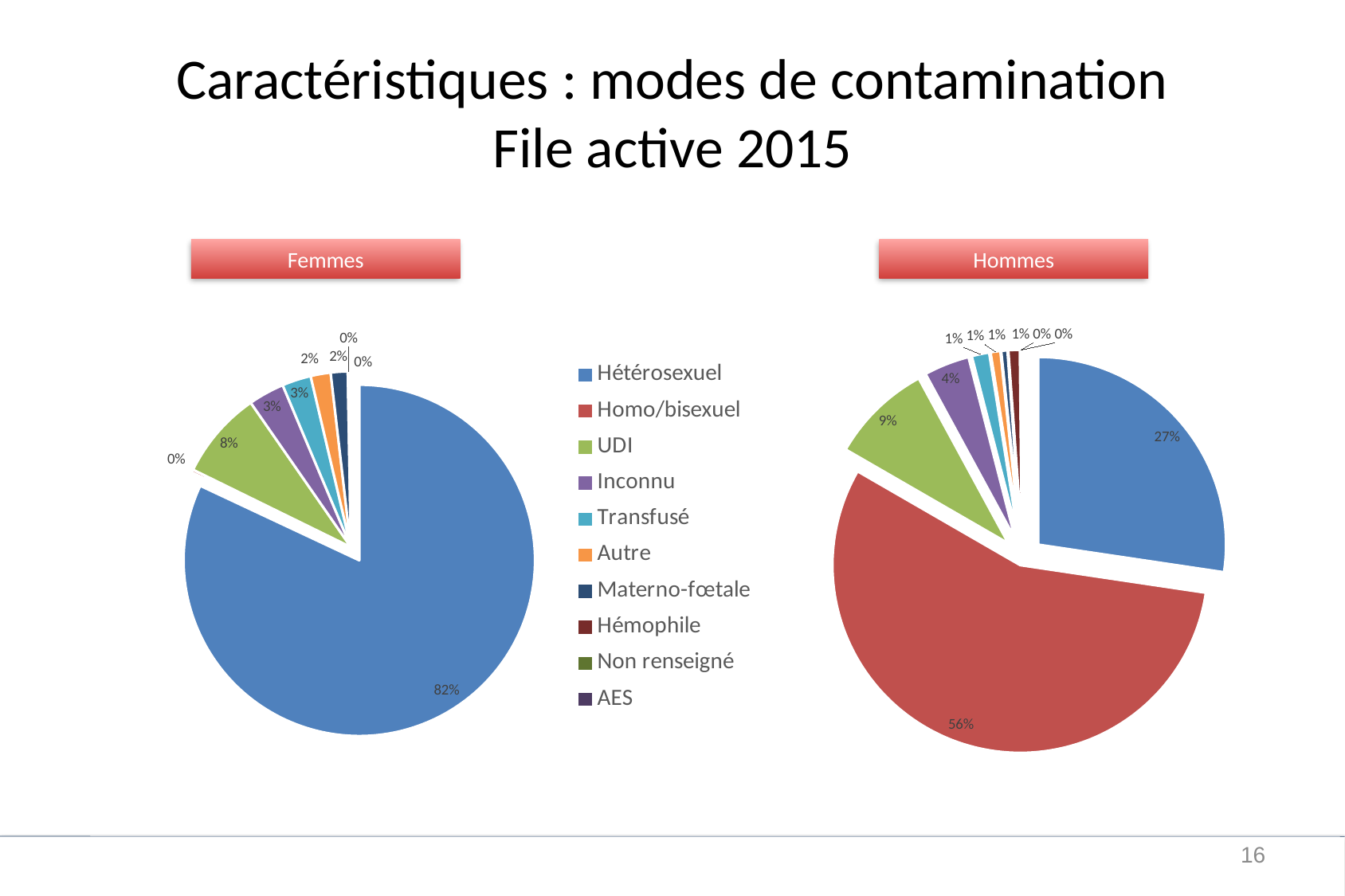
In the Femmes pie chart, which mode of contamination has the largest slice? Hétérosexuel In the Hommes pie chart, what share is labelled for the UDI slice? 9% In the Femmes pie chart, what share is labelled for the UDI slice? 8% In the Hommes pie chart, what share is labelled for the Inconnu slice? 4% In the Hommes pie chart, what share is labelled for the Homo/bisexuel slice? 56% How many entries does the shared legend list? 10 Which chart shows a larger share for UDI, Femmes or Hommes? Hommes What type of chart is used for the Femmes and Hommes data? Pie chart In the Hommes pie chart, which mode of contamination has the largest slice? Homo/bisexuel In the Femmes pie chart, what share is labelled for the Hétérosexuel slice? 82% In the Hommes pie chart, by how many percentage points does the Homo/bisexuel share exceed the Hétérosexuel share? 29 percentage points In the Hommes pie chart, what share is labelled for the Hétérosexuel slice? 27%